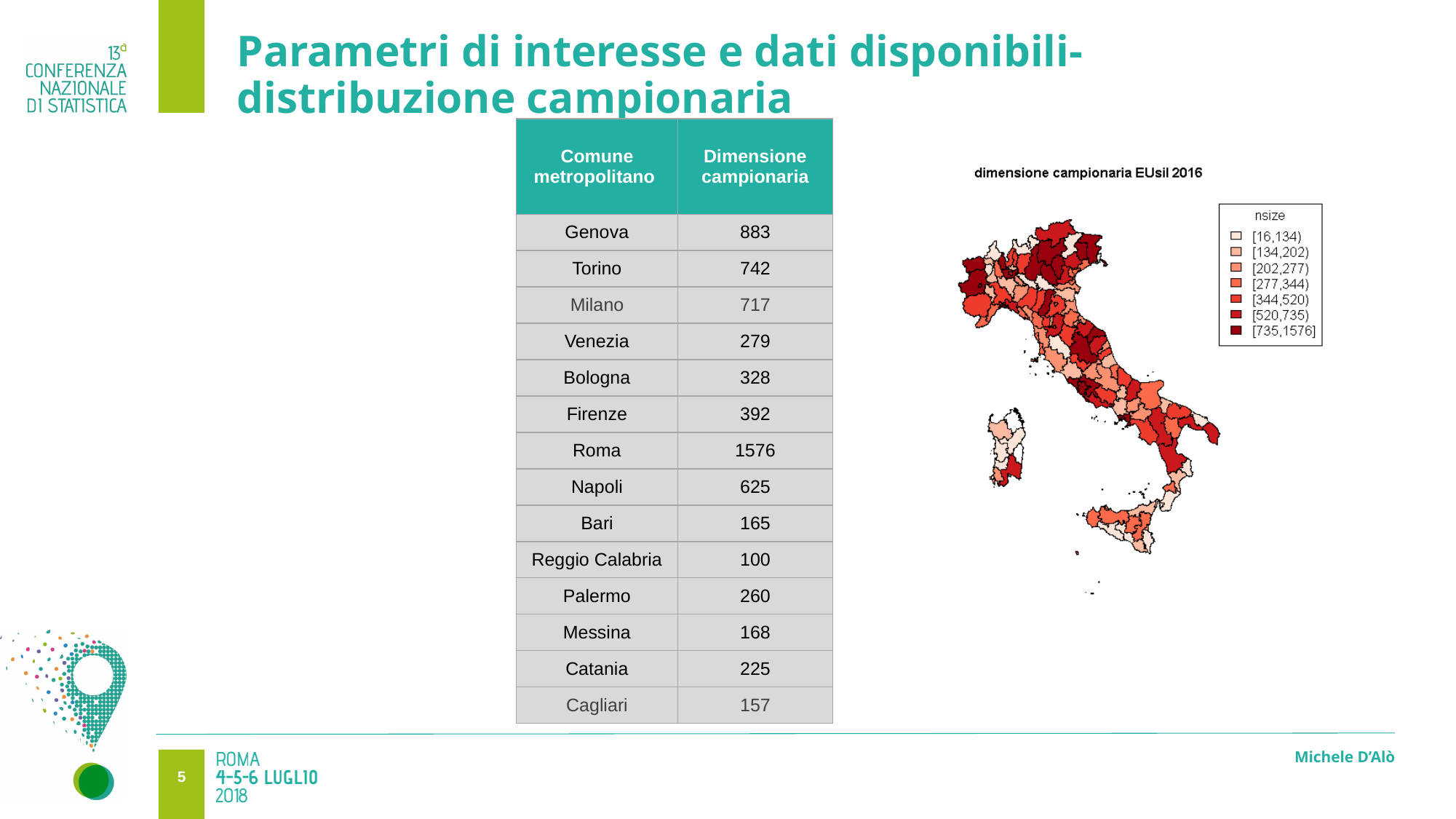
In the table, what is the sample size for Cagliari? 157 What is the highest value class shown in the map legend? [735,1576] In the table, what is the difference between the sample sizes of Torino and Milano? 25 In the table, what is the sample size for Napoli? 625 In the table, which comune metropolitano has the smallest sample size? Reggio Calabria How many comuni metropolitani are listed in the table? 14 In the table, what is the sample size (Dimensione campionaria) for Genova? 883 In the table, which has a larger sample size, Firenze or Bologna? Firenze What kind of chart is shown on the right of the slide? A choropleth map of Italy In the table, which comune metropolitano has the largest sample size? Roma How many value classes does the legend of the map list? 7 What is the title of the map on the right of the slide? dimensione campionaria EUsil 2016